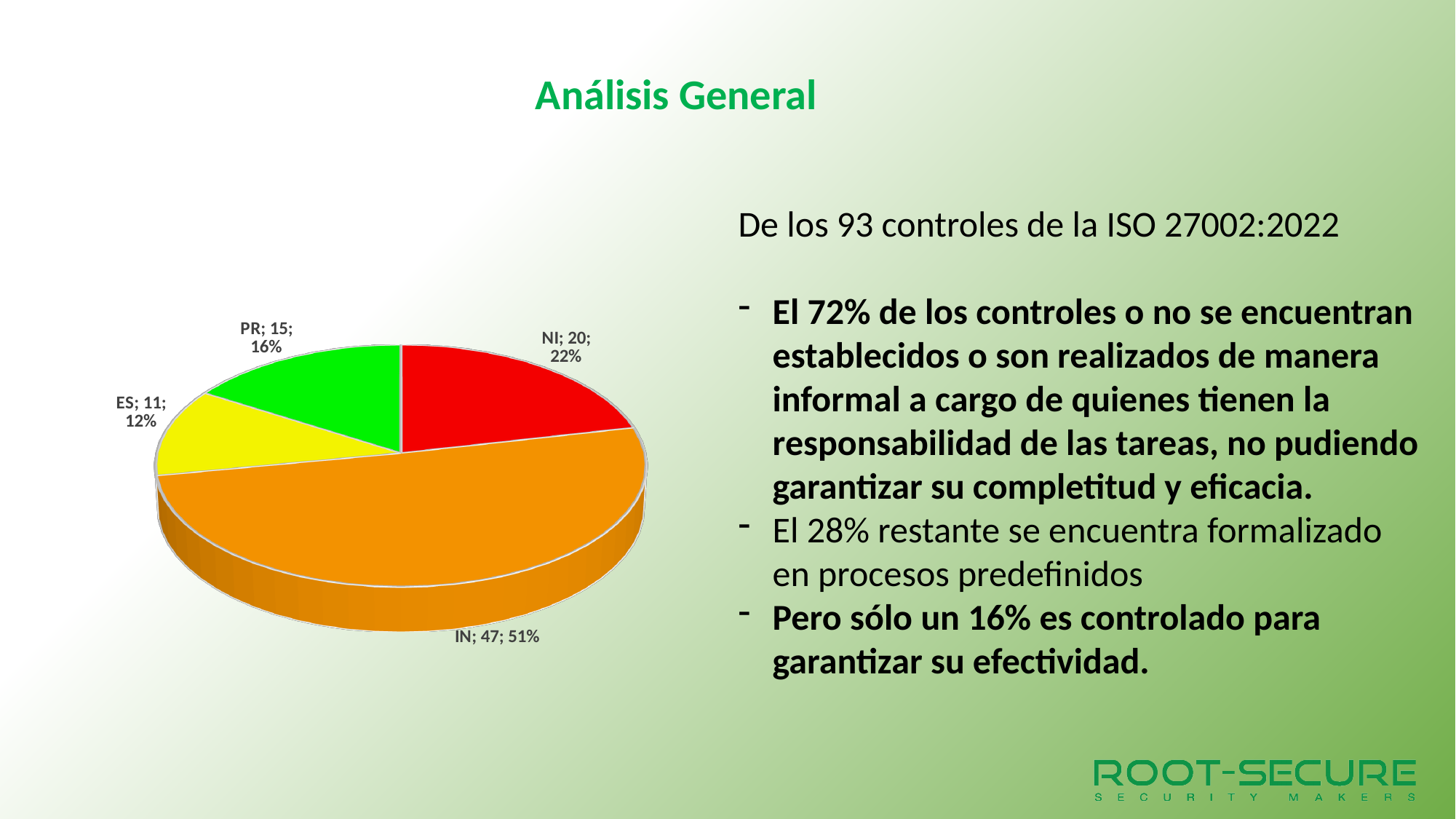
What is the total of all the slice values in the pie chart? 93 What colour is the IN slice in the pie chart? Orange How many slices does the pie chart have? 4 Which is larger, the value for PR or the value for ES? PR What percentage share does NI have in the pie chart? 22% What kind of chart is shown on the slide? Pie chart What percentage share does PR have in the pie chart? 16% Which category has the largest slice in the pie chart? IN What is the value for ES in the pie chart? 11 Which category has the smallest slice in the pie chart? ES What is the value for IN in the pie chart? 47 What is the difference between the values for IN and NI? 27